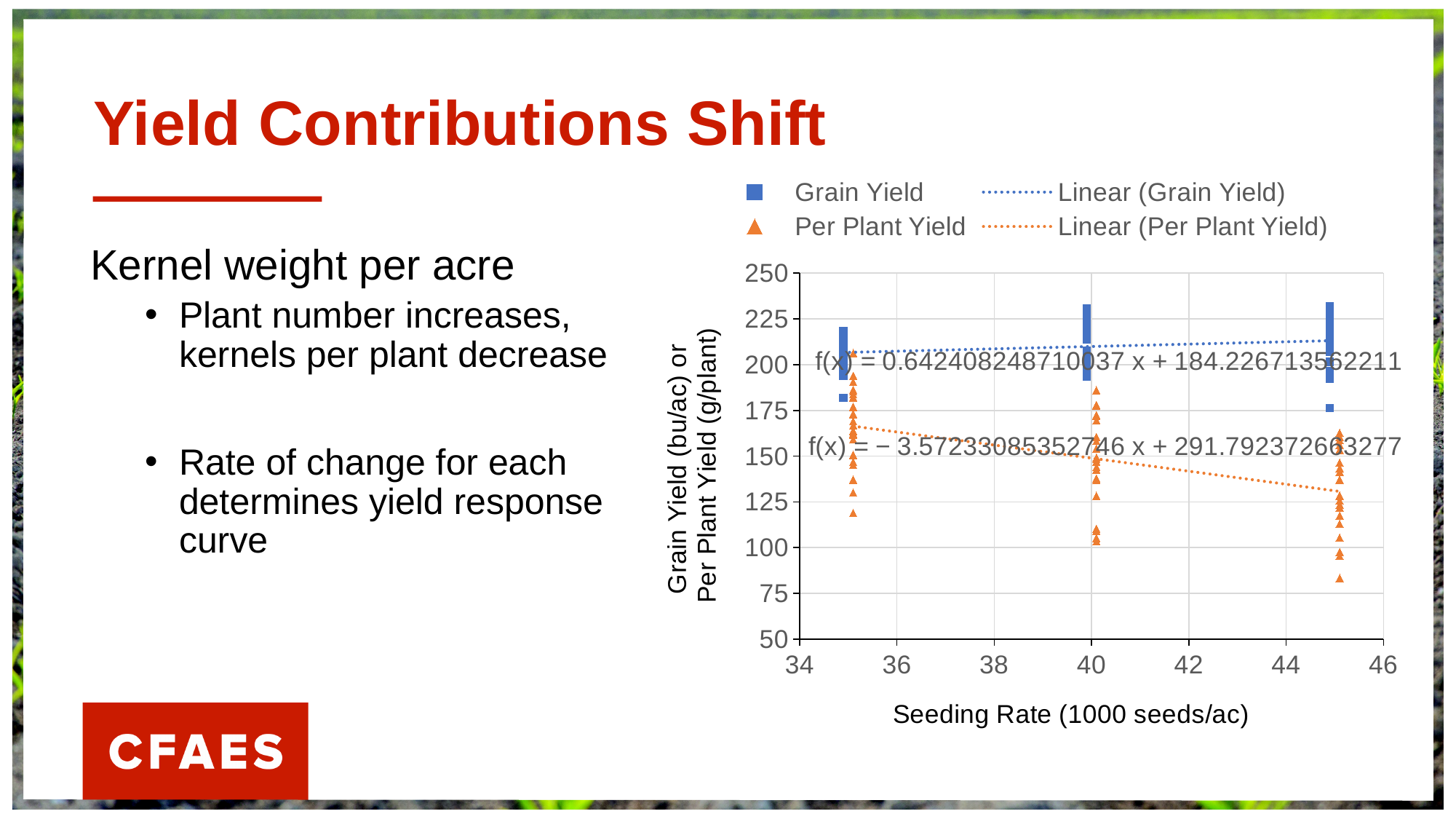
What kind of chart is shown on the slide? scatter chart How many distinct seeding rate levels have data points plotted? 3 What is the intercept shown in the trendline equation for Per Plant Yield? 291.792372663277 What is the title of the x axis of the chart? Seeding Rate (1000 seeds/ac) How many entries does the chart legend list? 4 What is the slope shown in the trendline equation for Grain Yield? 0.642082248710037 What is the intercept shown in the trendline equation for Grain Yield? 184.226713562211 What is the slope shown in the trendline equation for Per Plant Yield? − 3.57233085352746 Does the Linear (Grain Yield) trendline rise or fall as seeding rate increases? rise Is the lowest Per Plant Yield point at a seeding rate of 45 greater or less than 100? less Which series has higher plotted values overall, Grain Yield or Per Plant Yield? Grain Yield Does the Linear (Per Plant Yield) trendline rise or fall as seeding rate increases? fall